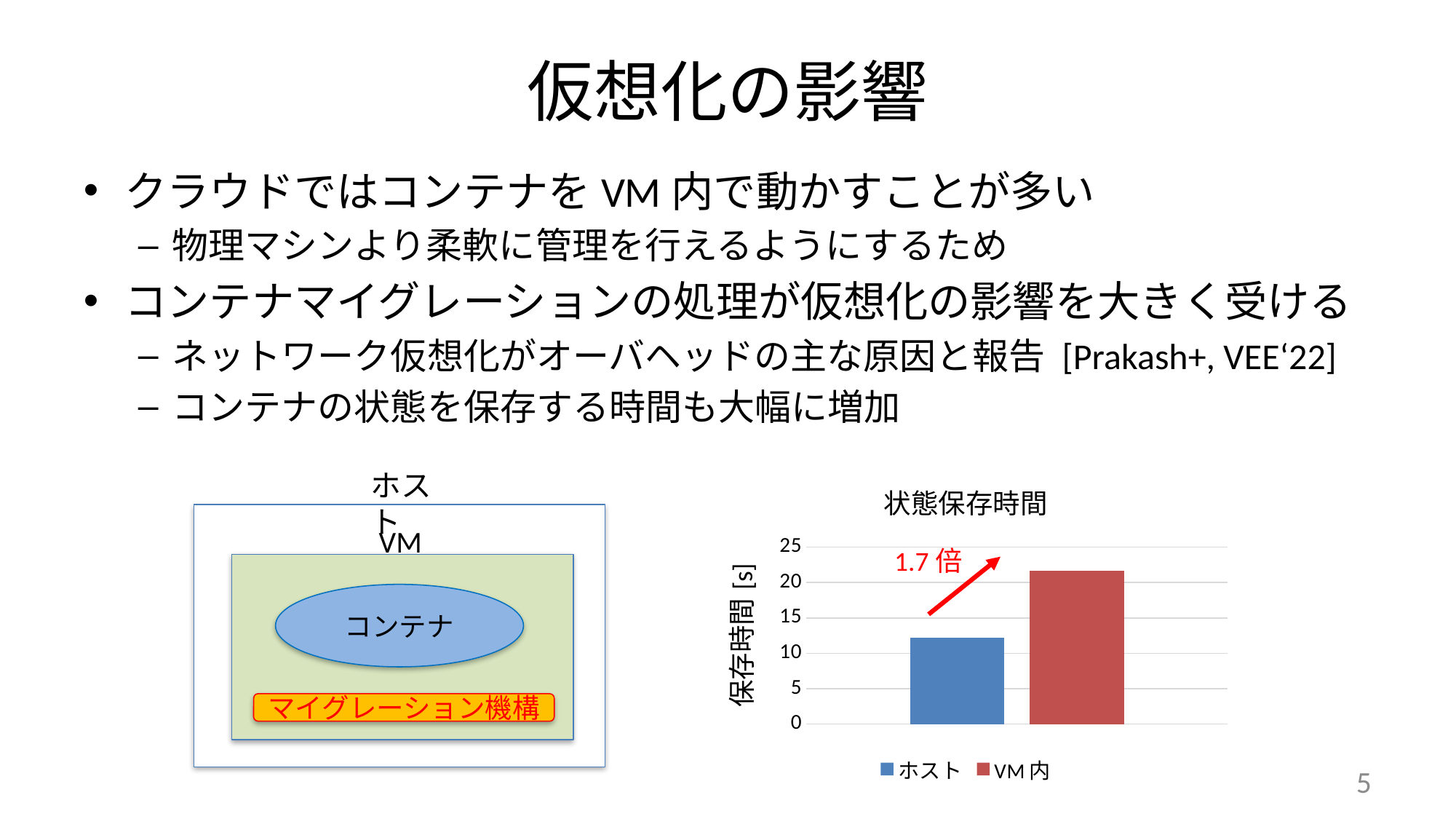
What kind of chart is shown on the slide? bar chart Is the value for ホスト greater or less than 15? less What is the label of the vertical axis of the chart? 保存時間 [s] How many series does the chart legend list? 2 Is the value for VM 内 greater or less than 20? greater What is the highest tick value shown on the vertical axis? 25 Which series has the lowest value in the chart? ホスト Which is larger, the value for ホスト or the value for VM 内? VM 内 Which series has the highest value in the chart? VM 内 What is the title of the chart? 状態保存時間 Is the value for ホスト greater or less than 10? greater